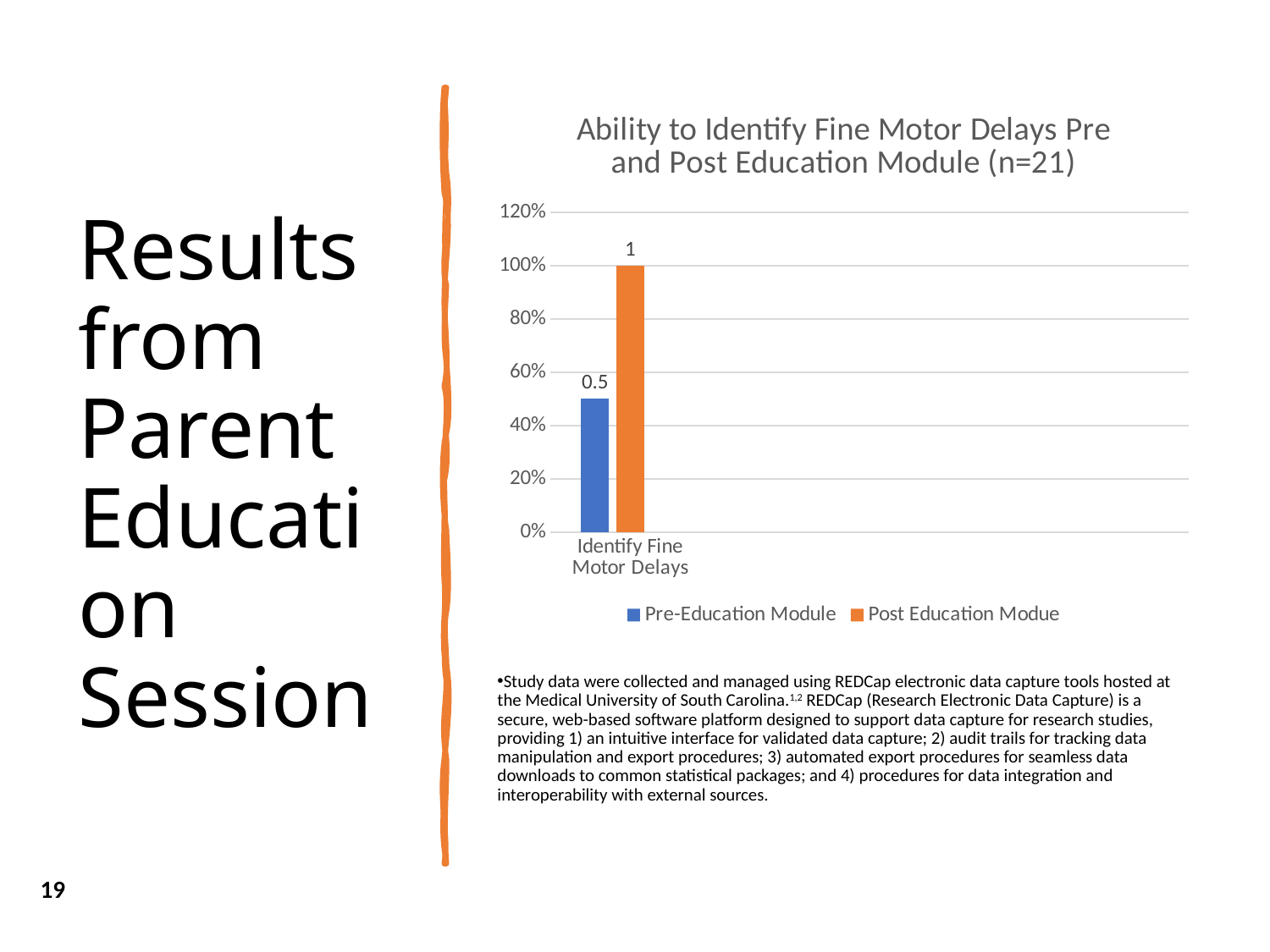
What colour is the Post Education Modue bar? orange Which series has the higher value for Identify Fine Motor Delays? Post Education Modue How many series does the legend list? 2 What is the difference between the Post Education Modue and Pre-Education Module data labels? 0.5 Is the Post Education Modue bar greater or less than 80%? greater What is the data label on the Post Education Modue bar for Identify Fine Motor Delays? 1 What kind of chart is shown on the slide? bar chart What is the title of the chart? Ability to Identify Fine Motor Delays Pre and Post Education Module (n=21) Is the Pre-Education Module bar greater or less than 60%? less How many categories are shown on the x axis? 1 What is the data label on the Pre-Education Module bar for Identify Fine Motor Delays? 0.5 What is the highest value shown on the y axis? 120%